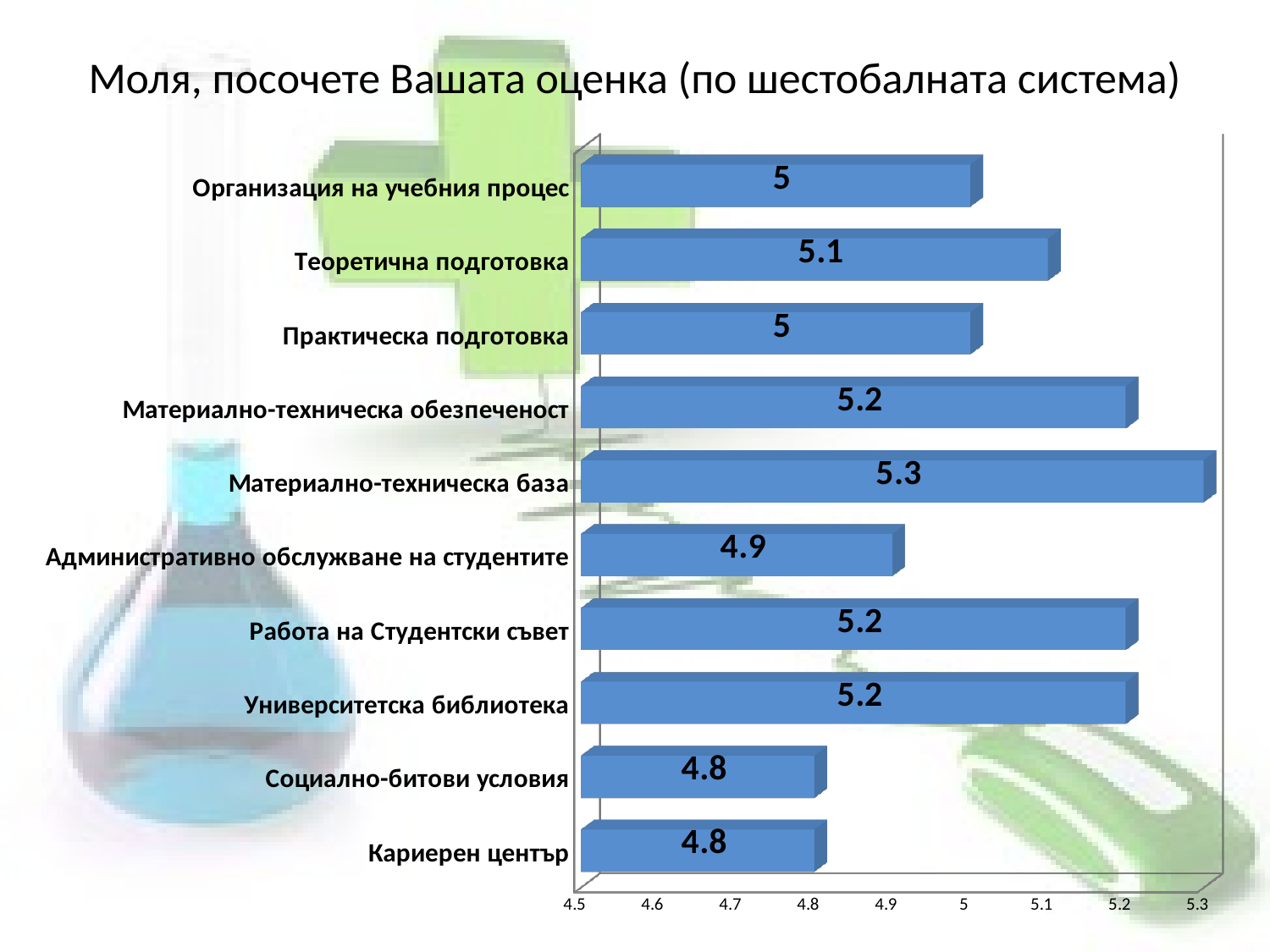
Which category has the highest value? Материално-техническа база Which is larger, the value for Теоретична подготовка or the value for Административно обслужване на студентите? Теоретична подготовка What is the title of the slide? Моля, посочете Вашата оценка (по шестобалната система) What is the value for Материално-техническа обезпеченост? 5.2 Is the value for Кариерен център greater or less than 5? less How many categories are shown in the chart? 10 What is the difference between the values for Материално-техническа база and Социално-битови условия? 0.5 What is the value for Кариерен център? 4.8 What is the difference between the values for Теоретична подготовка and Организация на учебния процес? 0.1 What is the value for Административно обслужване на студентите? 4.9 What is the value for Теоретична подготовка? 5.1 What kind of chart is shown on the slide? bar chart